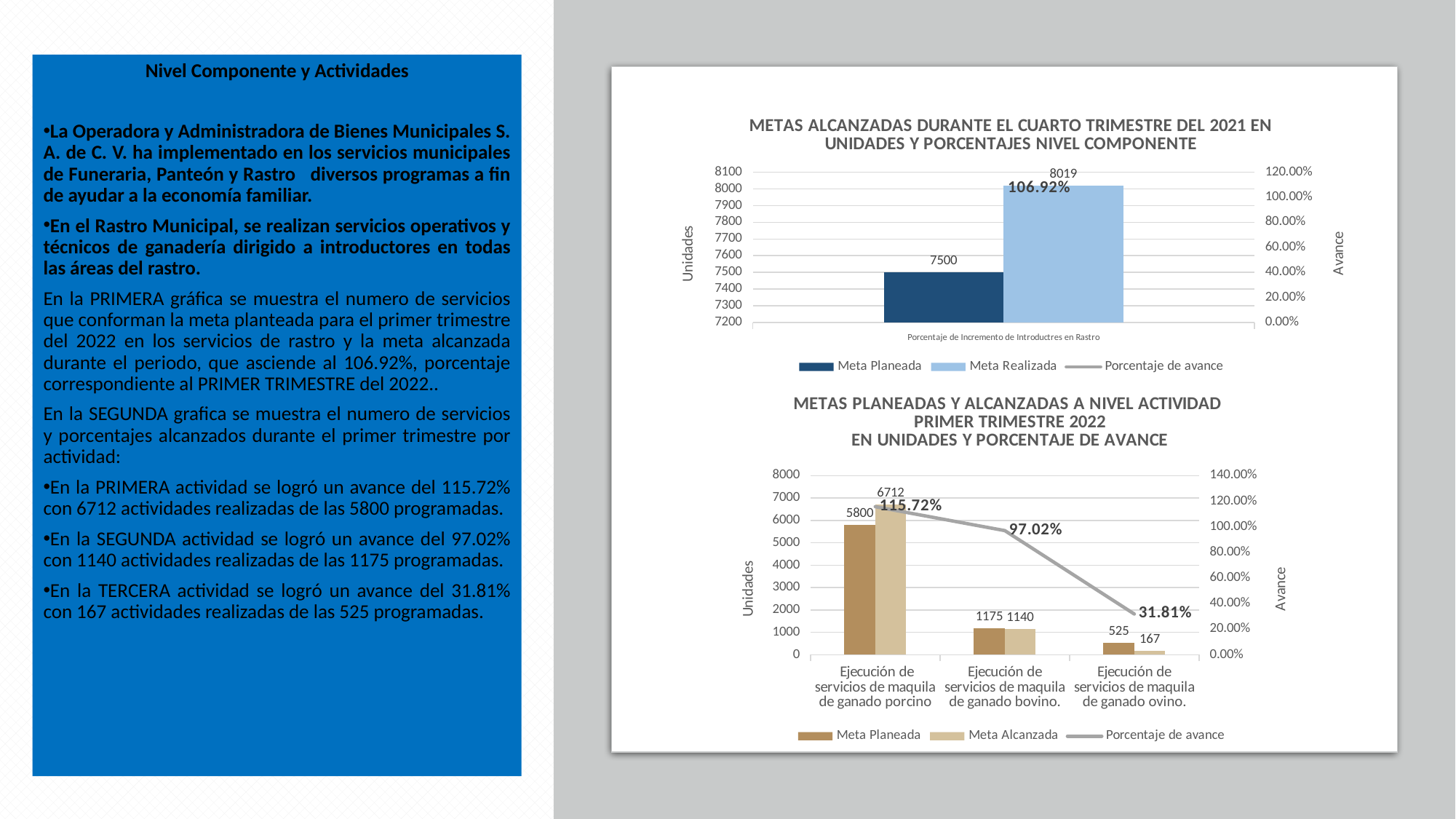
In the top chart, how many series does the legend list? 3 In the bottom chart, does the Porcentaje de avance line rise or fall from left to right? fall In the bottom chart, what is the Porcentaje de avance for Ejecución de servicios de maquila de ganado bovino? 97.02% In the bottom chart, what is the Meta Planeada for Ejecución de servicios de maquila de ganado ovino? 525 In the bottom chart, which category has the lowest Meta Alcanzada? Ejecución de servicios de maquila de ganado ovino In the top chart, what is the value of Meta Realizada? 8019 In the bottom chart, what is the Meta Alcanzada for Ejecución de servicios de maquila de ganado porcino? 6712 In the top chart, what is the value of Meta Planeada? 7500 In the bottom chart, how many categories are shown on the x axis? 3 In the top chart, what is the Porcentaje de avance shown? 106.92% In the top chart, what is the difference between Meta Realizada and Meta Planeada? 519 In the bottom chart, what is the difference between Meta Planeada and Meta Alcanzada for Ejecución de servicios de maquila de ganado bovino? 35